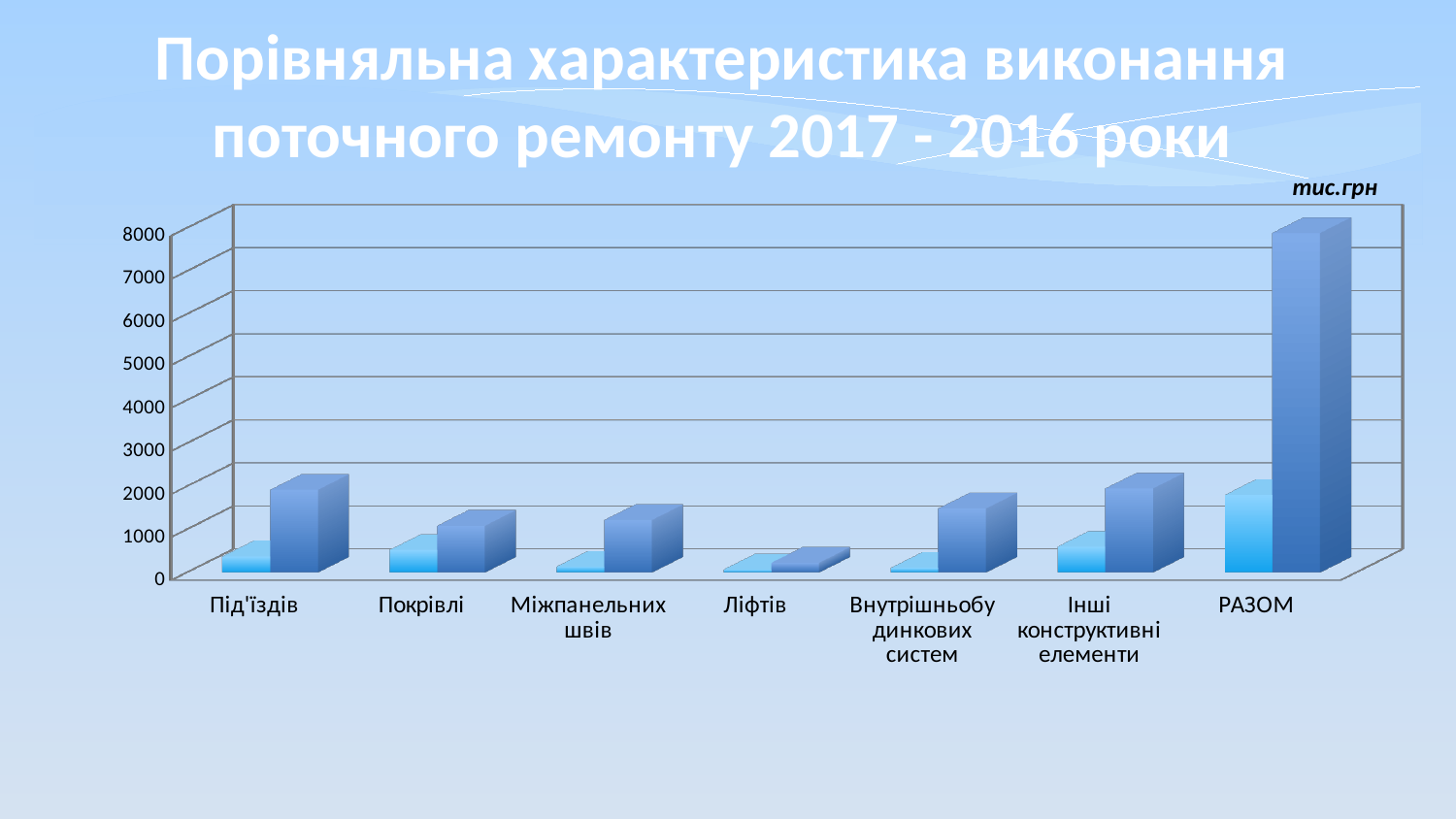
What unit is indicated above the chart? тис.грн Which category has the shortest dark blue bar? Ліфтів Is the dark blue bar for Внутрішньобудинкових систем greater or less than 3000? less How many categories are shown on the x axis of the chart? 7 Is the dark blue bar for Під'їздів greater or less than 1000? greater Is the light blue bar for РАЗОМ greater or less than 3000? less Which has the taller dark blue bar, Під'їздів or Покрівлі? Під'їздів What kind of chart is shown on the slide? bar chart Which category has the tallest dark blue bar? РАЗОМ Which has the taller dark blue bar, Міжпанельних швів or Ліфтів? Міжпанельних швів